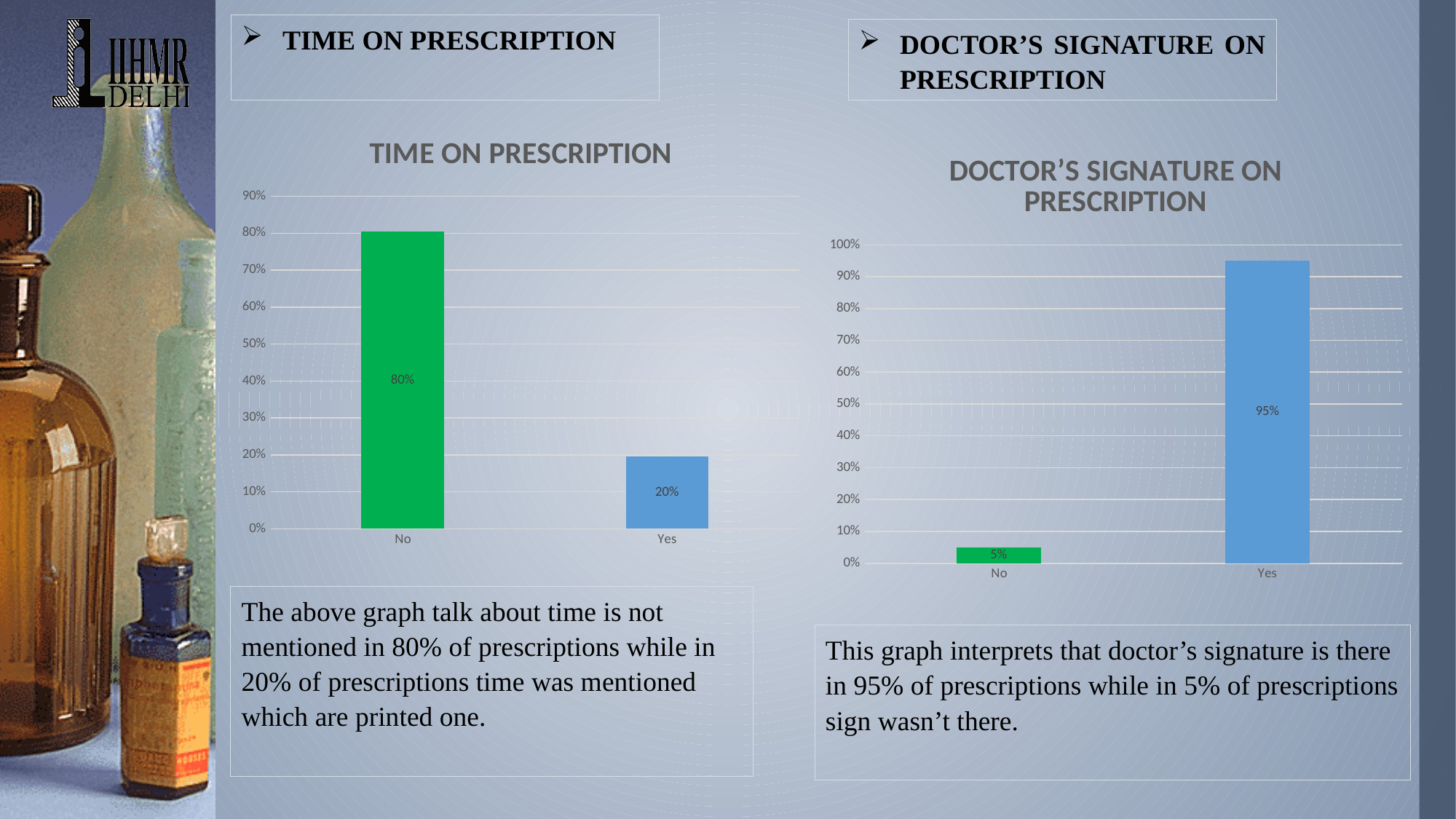
In the 'TIME ON PRESCRIPTION' chart, what is the difference between the values for 'No' and 'Yes'? 60% In the 'DOCTOR'S SIGNATURE ON PRESCRIPTION' chart, which category has the lowest value? No In the 'TIME ON PRESCRIPTION' chart, what is the value for 'No'? 80% In the 'DOCTOR'S SIGNATURE ON PRESCRIPTION' chart, which is larger, the value for 'Yes' or the value for 'No'? Yes In the 'TIME ON PRESCRIPTION' chart, what is the value for 'Yes'? 20% In the 'TIME ON PRESCRIPTION' chart, what colour is the bar for 'No'? Green In the 'DOCTOR'S SIGNATURE ON PRESCRIPTION' chart, what is the difference between the values for 'Yes' and 'No'? 90% What kind of chart is the 'DOCTOR'S SIGNATURE ON PRESCRIPTION' chart? Bar chart In the 'TIME ON PRESCRIPTION' chart, which category has the highest value? No In the 'DOCTOR'S SIGNATURE ON PRESCRIPTION' chart, what is the value for 'Yes'? 95% How many categories are shown in the 'TIME ON PRESCRIPTION' chart? 2 In the 'DOCTOR'S SIGNATURE ON PRESCRIPTION' chart, what is the value for 'No'? 5%